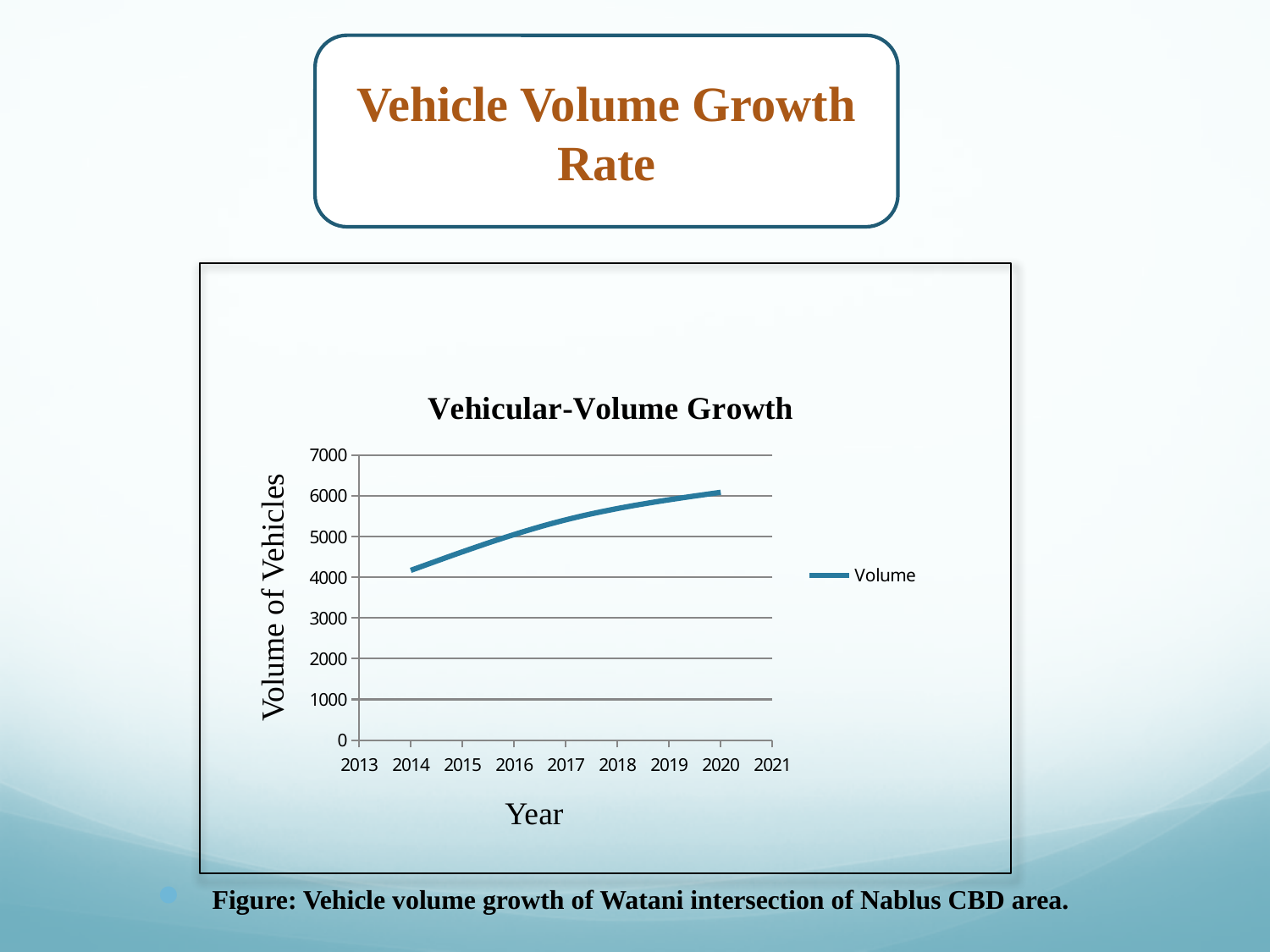
Which year has the lowest vehicle volume? 2014 What kind of chart is shown on the slide? line chart Does the vehicle volume rise or fall from 2014 to 2020? rise Which year has the highest vehicle volume? 2020 Is the value for 2020 greater or less than 5000? greater What is the title of the chart? Vehicular-Volume Growth What is the label on the y axis of the chart? Volume of Vehicles How many series does the legend list? 1 Is the value for 2014 greater or less than 5000? less